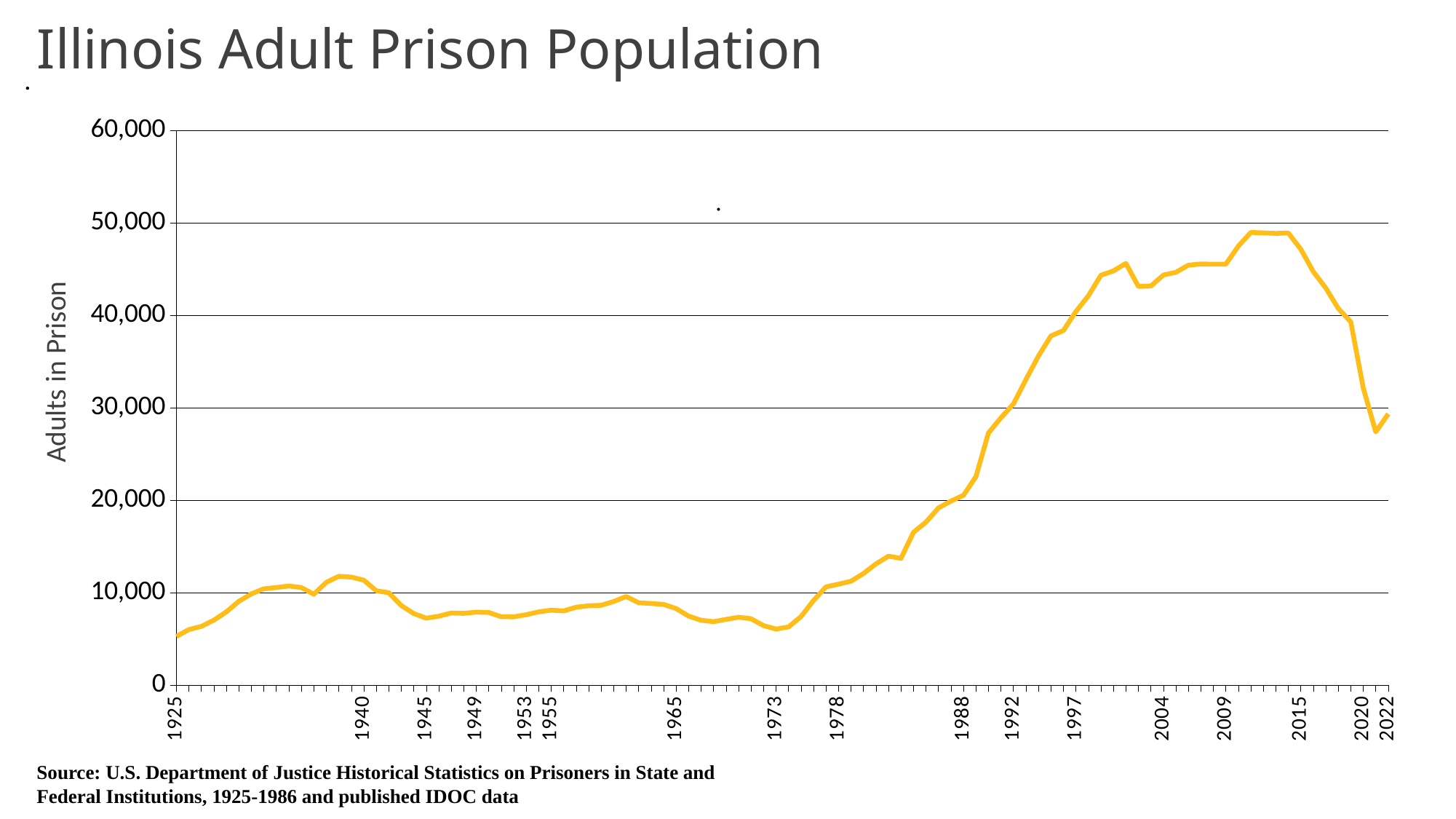
Does the prison population rise or fall between 1973 and 2015? rise What kind of chart is shown on the slide? line chart Does the prison population rise or fall between 2015 and 2022? fall What is the title of the chart? Illinois Adult Prison Population Is the value for 1973 greater or less than 10,000? less What is the label on the vertical axis? Adults in Prison Is the value for 2015 greater or less than 50,000? less Is the value for 2004 greater or less than 40,000? greater